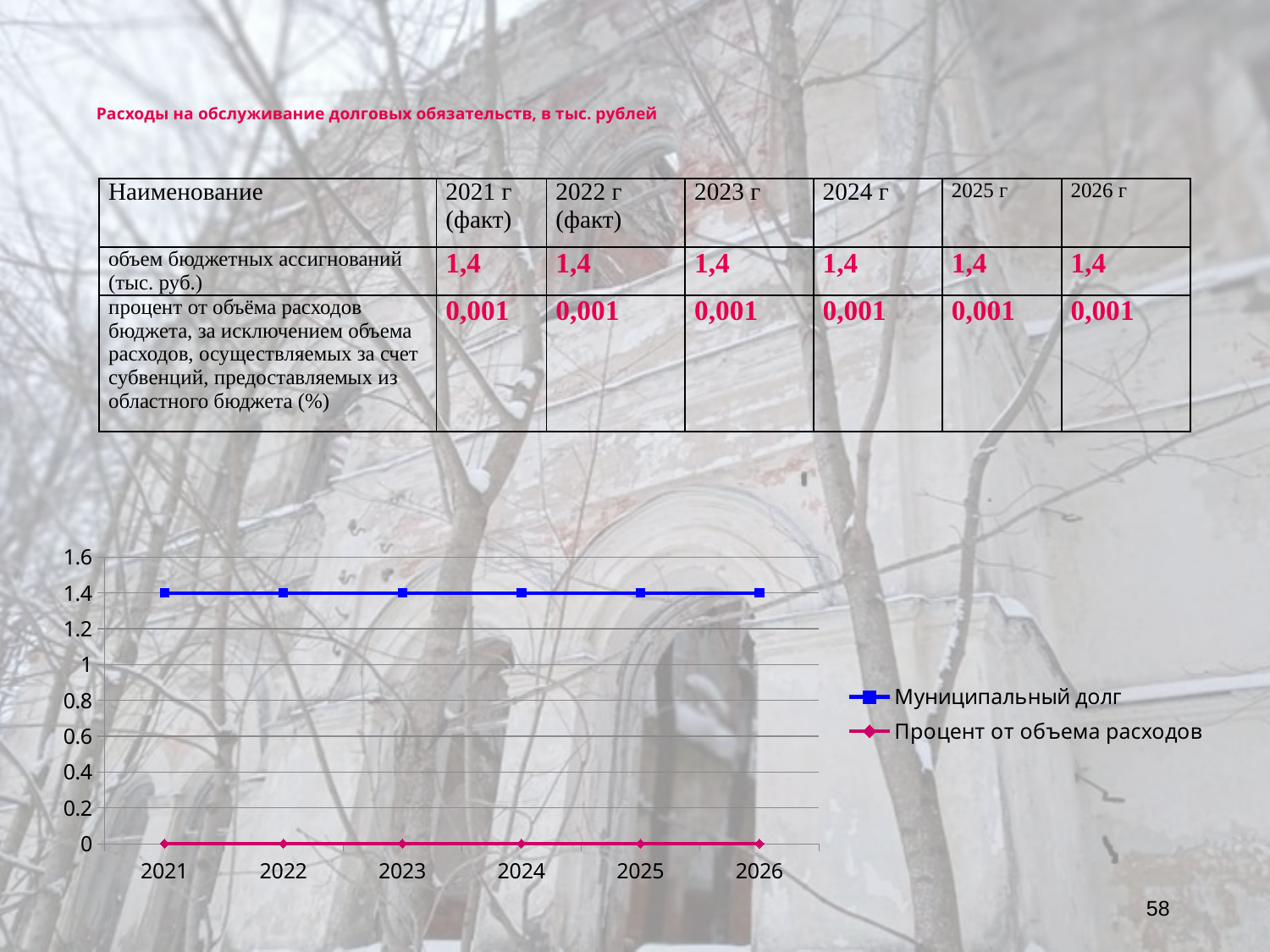
Which series is plotted in blue on the chart? Муниципальный долг What is the value of the Муниципальный долг series in 2021? 1.4 What is the value of the Муниципальный долг series in 2026? 1.4 How many series does the chart legend list? 2 Is the value of Процент от объема расходов in 2023 greater or less than 0.2? less Which series has the higher value in 2025, Муниципальный долг or Процент от объема расходов? Муниципальный долг What kind of chart is shown on the slide? line chart How many years are shown along the x axis of the chart? 6 Does the Муниципальный долг series rise, fall or stay flat from 2021 to 2026? stays flat What is the highest tick value shown on the y axis of the chart? 1.6 What is the first year shown on the x axis of the chart? 2021 Is the value of Муниципальный долг in 2024 greater or less than 1? greater